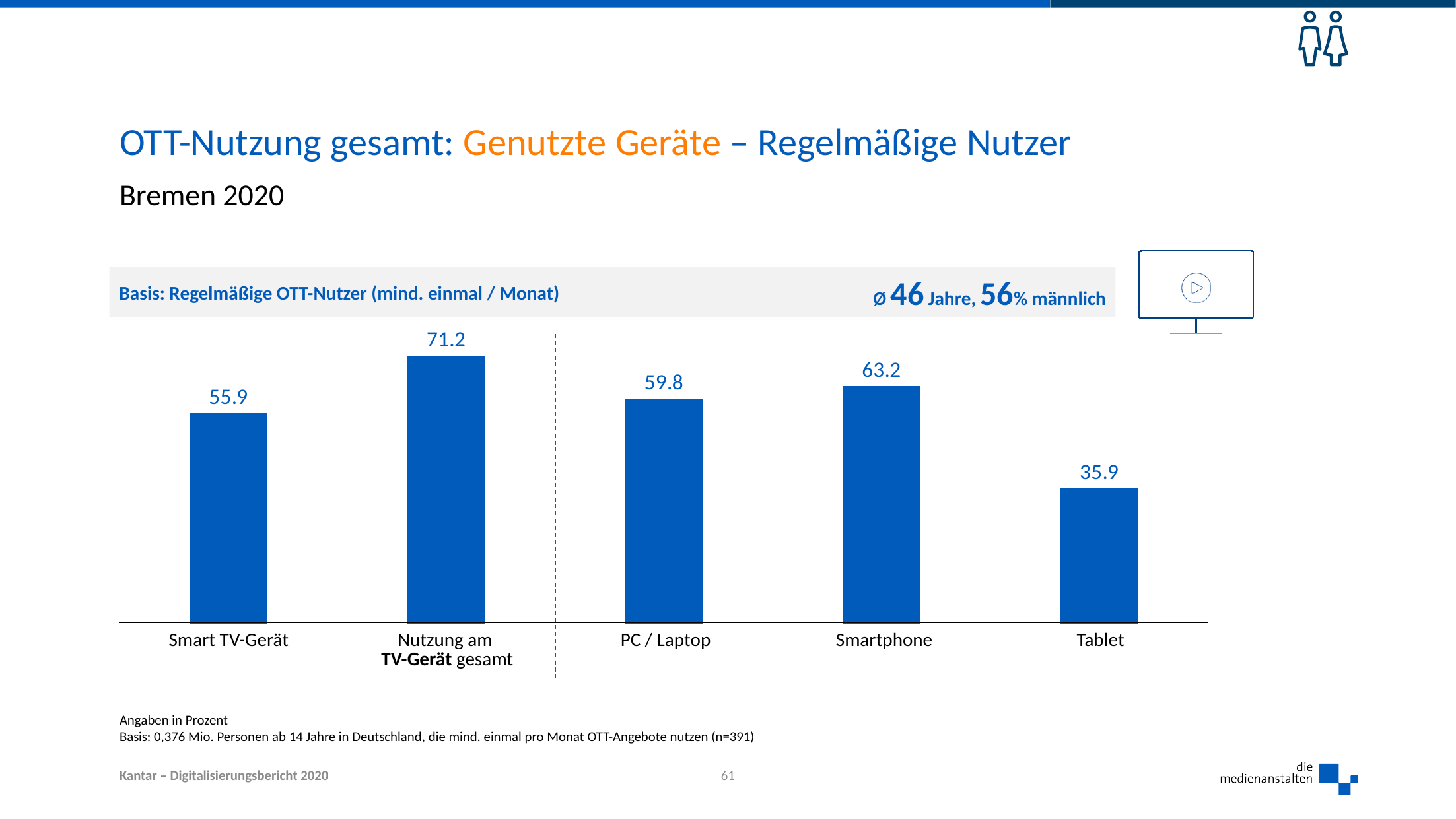
Which category has the highest value? Nutzung am TV-Gerät gesamt Which category has the lowest value? Tablet What is the difference between the values for Smartphone and PC / Laptop? 3.4 What is the difference between the values for Nutzung am TV-Gerät gesamt and Tablet? 35.3 What is the value for PC / Laptop? 59.8 What is the value for Tablet? 35.9 What is the value for Nutzung am TV-Gerät gesamt? 71.2 What is the value for Smart TV-Gerät? 55.9 Which is larger, the value for Smartphone or the value for Smart TV-Gerät? Smartphone What is the value for Smartphone? 63.2 How many categories are shown in the chart? 5 What kind of chart is shown on the slide? Bar chart